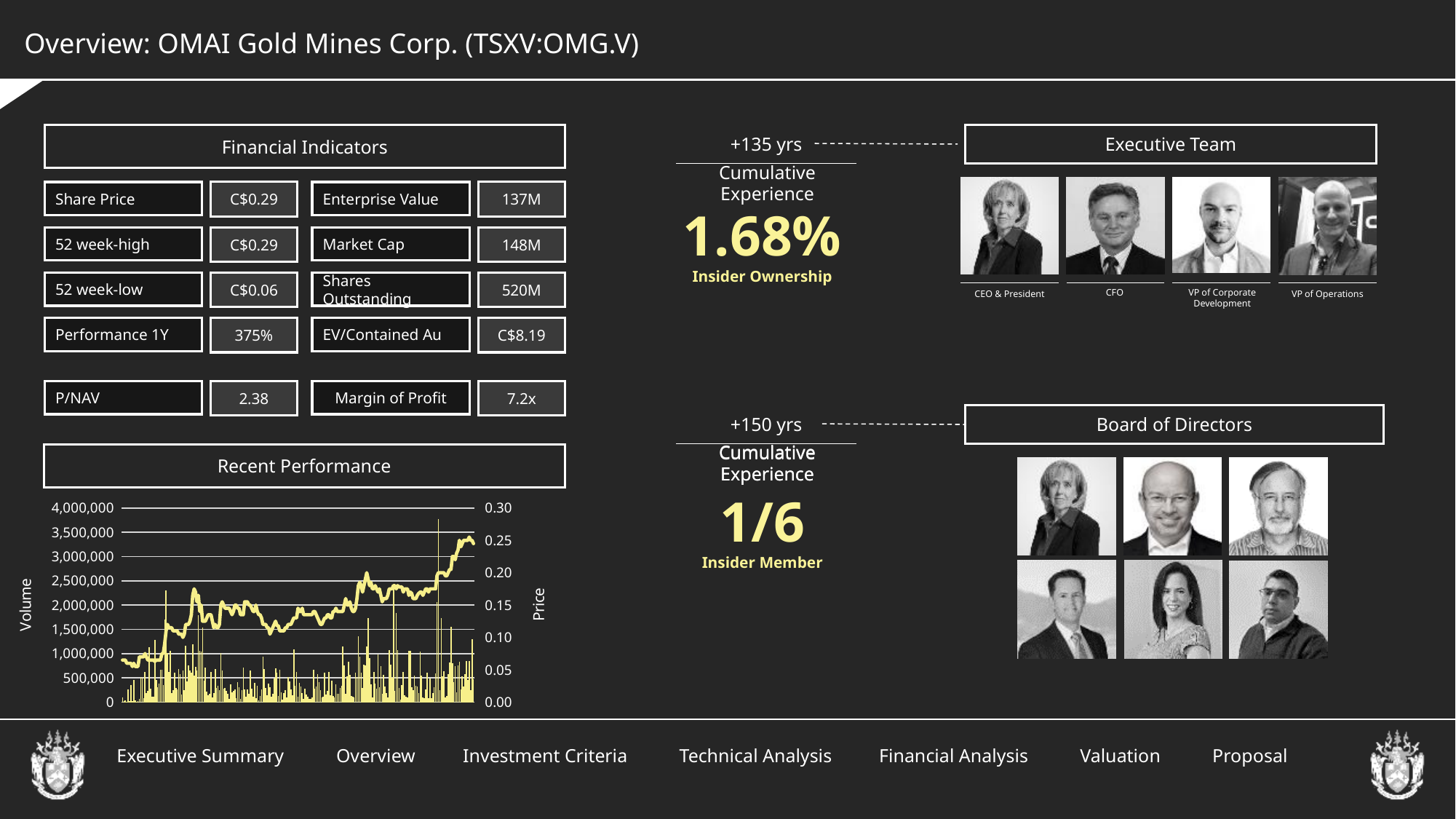
What is the title of the chart on the slide? Recent Performance How many tick labels are shown on the right (Price) axis of the Recent Performance chart? 7 In the Recent Performance chart, is the tallest volume bar greater or less than 3,000,000? greater How many tick labels are shown on the left (Volume) axis of the Recent Performance chart? 9 What is the title of the left vertical axis of the Recent Performance chart? Volume In the Recent Performance chart, is the price at the right end of the line greater or less than 0.20? greater What is the highest tick value shown on the left (Volume) axis of the Recent Performance chart? 4,000,000 What kind of chart is the Recent Performance chart? A combination chart with bars (volume) and a line (price) Does the price line in the Recent Performance chart generally rise or fall from left to right? Rise In the Recent Performance chart, is the price at the left start of the line greater or less than 0.10? less What is the title of the right vertical axis of the Recent Performance chart? Price What is the highest tick value shown on the right (Price) axis of the Recent Performance chart? 0.30